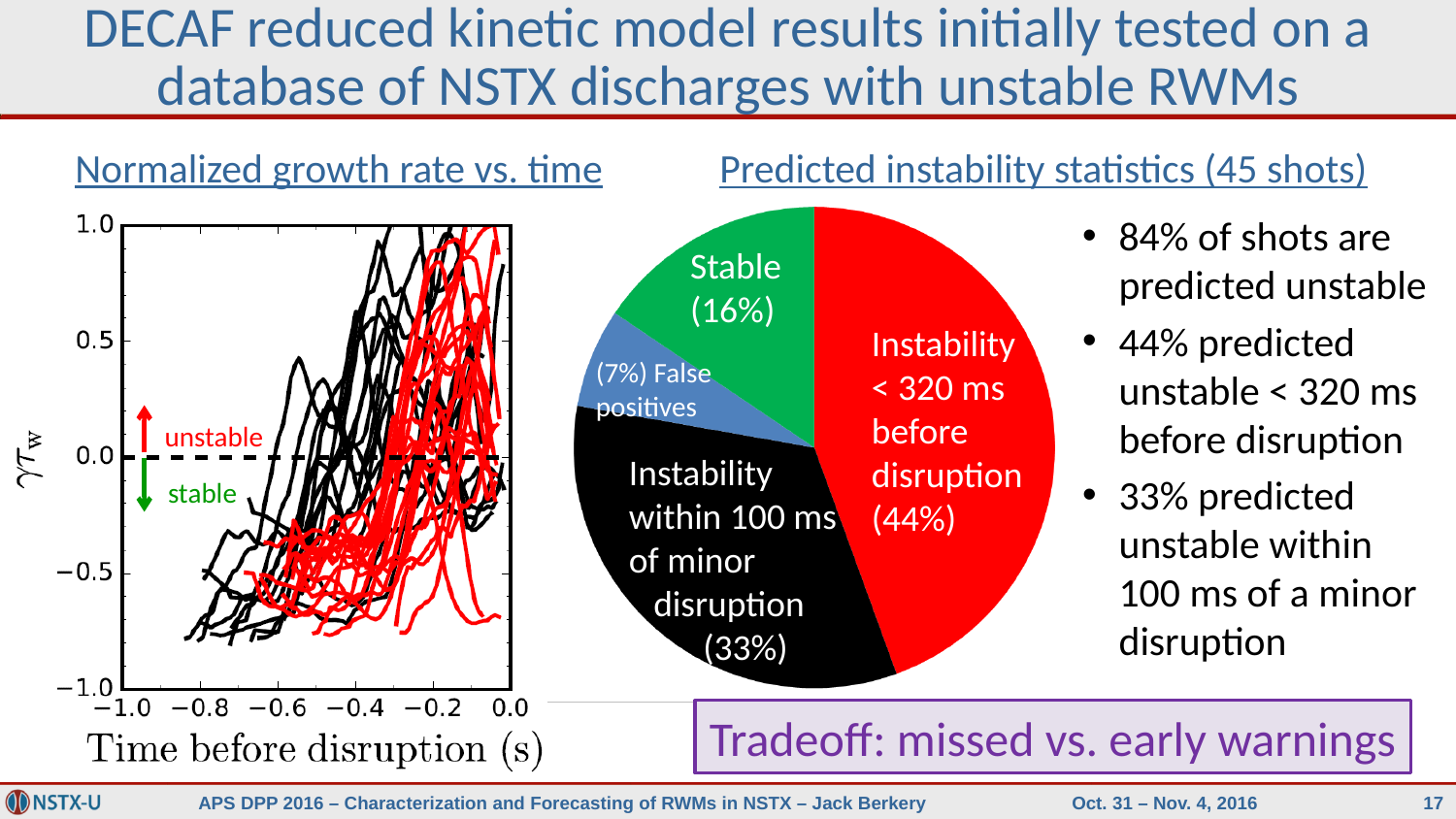
In the 'Predicted instability statistics (45 shots)' pie chart, which slice is larger: 'Stable' or 'False positives'? Stable What kind of chart is the 'Normalized growth rate vs. time' chart on the left of the slide? Line chart In the 'Predicted instability statistics (45 shots)' pie chart, what share of shots is labelled 'Stable'? 16% In the 'Predicted instability statistics (45 shots)' pie chart, how many slices are there? 4 In the 'Predicted instability statistics (45 shots)' pie chart, what share of shots is labelled 'Instability < 320 ms before disruption'? 44% In the 'Predicted instability statistics (45 shots)' pie chart, which slice is the largest? Instability < 320 ms before disruption In the 'Predicted instability statistics (45 shots)' pie chart, what colour is the 'Stable' slice? Green In the 'Normalized growth rate vs. time' chart, what is the label of the x axis? Time before disruption (s) In the 'Predicted instability statistics (45 shots)' pie chart, what is the difference in percentage points between the 'Instability < 320 ms before disruption' slice and the 'Instability within 100 ms of minor disruption' slice? 11 percentage points In the 'Predicted instability statistics (45 shots)' pie chart, which slice is the smallest? False positives In the 'Predicted instability statistics (45 shots)' pie chart, what share of shots is labelled 'Instability within 100 ms of minor disruption'? 33%